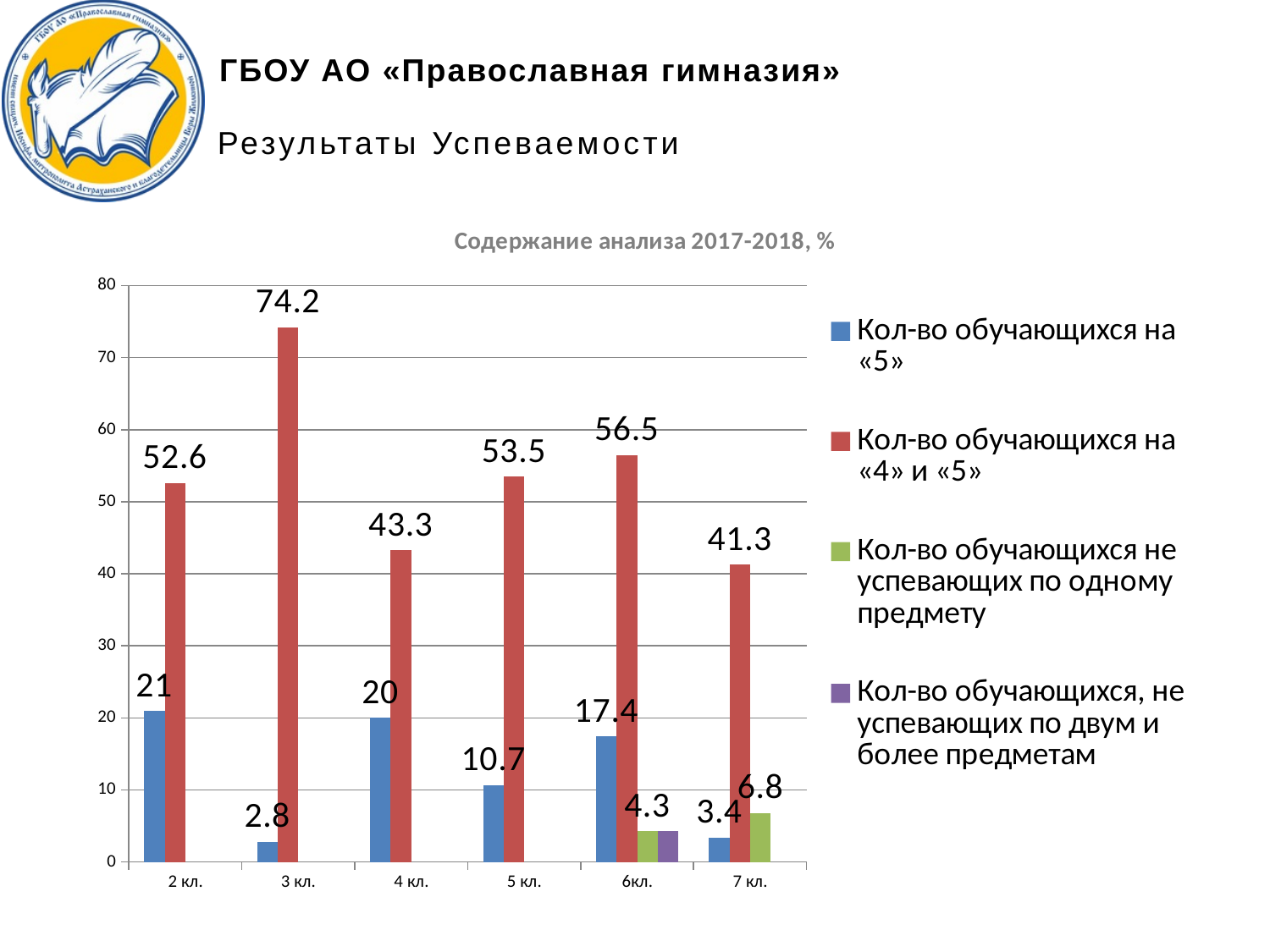
What is the value for «Кол-во обучающихся не успевающих по одному предмету» in 7 кл.? 6.8 Is the value for «Кол-во обучающихся на «4» и «5»» in 7 кл. greater or less than 40? greater What is the difference between the «4» и «5» values for 3 кл. and 2 кл.? 21.6 What is the value for «Кол-во обучающихся на «4» и «5»» in 3 кл.? 74.2 Which class has the larger value for «Кол-во обучающихся на «5»»: 4 кл. or 6кл.? 4 кл. Which class has the lowest value for «Кол-во обучающихся на «5»»? 3 кл. Which class has the highest value for «Кол-во обучающихся на «4» и «5»»? 3 кл. What kind of chart is shown on the slide? bar chart What is the title of the chart? Содержание анализа 2017-2018, % What is the value for «Кол-во обучающихся на «5»» in 2 кл.? 21 How many series does the legend list? 4 How many classes are shown on the x axis? 6